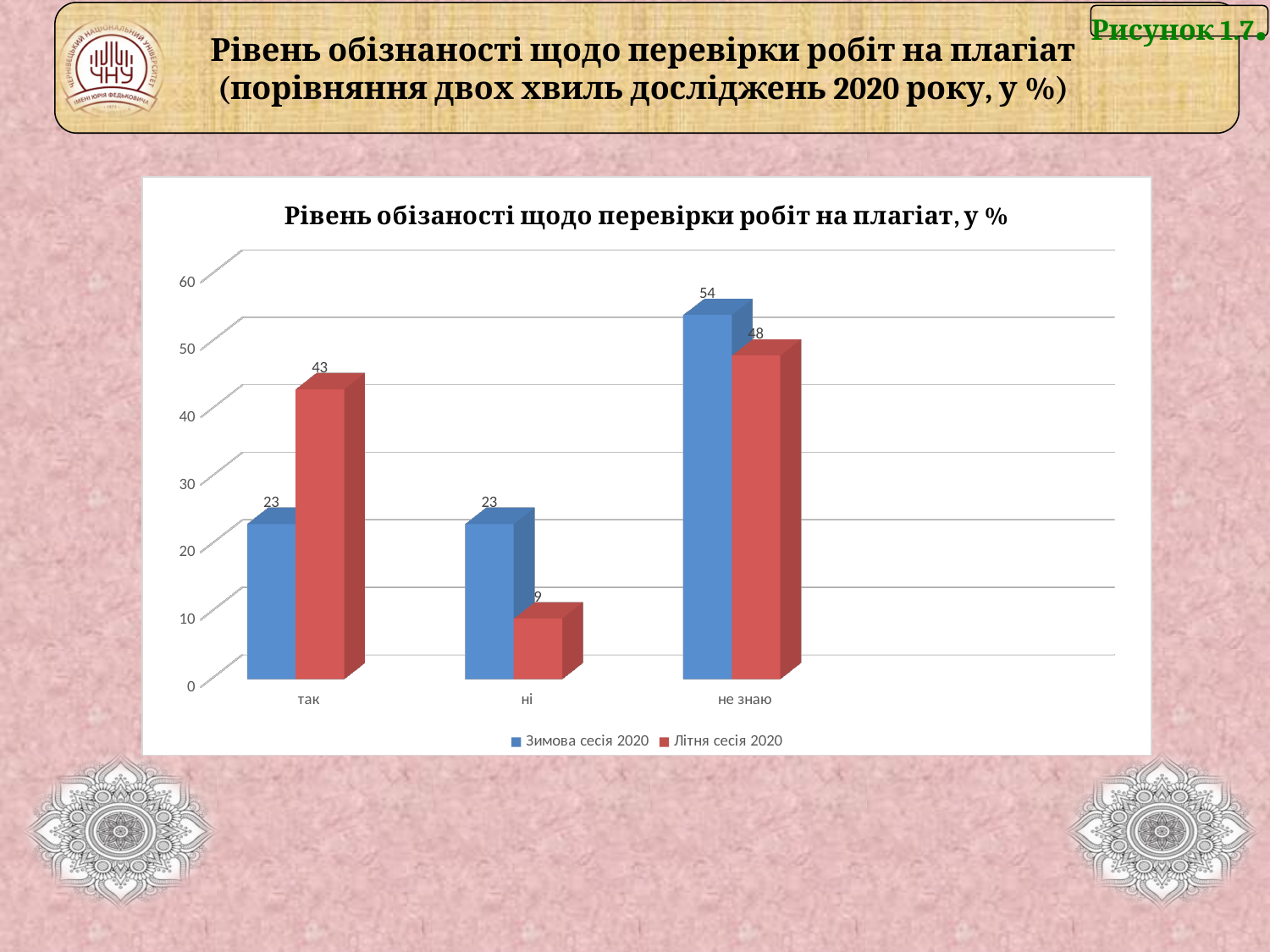
How many categories are shown on the x axis? 3 What is the value for "ні" in the "Літня сесія 2020" series? 9 What kind of chart is shown on the slide? Bar chart For "так", which series has the larger value: "Зимова сесія 2020" or "Літня сесія 2020"? Літня сесія 2020 What is the value for "так" in the "Літня сесія 2020" series? 43 Which category has the lowest value in the "Літня сесія 2020" series? ні How many series does the legend list? 2 What is the difference between the "Зимова сесія 2020" and "Літня сесія 2020" values for "не знаю"? 6 Which category has the highest value in the "Літня сесія 2020" series? не знаю What is the value for "не знаю" in the "Зимова сесія 2020" series? 54 What is the difference between the "Зимова сесія 2020" and "Літня сесія 2020" values for "ні"? 14 What is the value for "так" in the "Зимова сесія 2020" series? 23